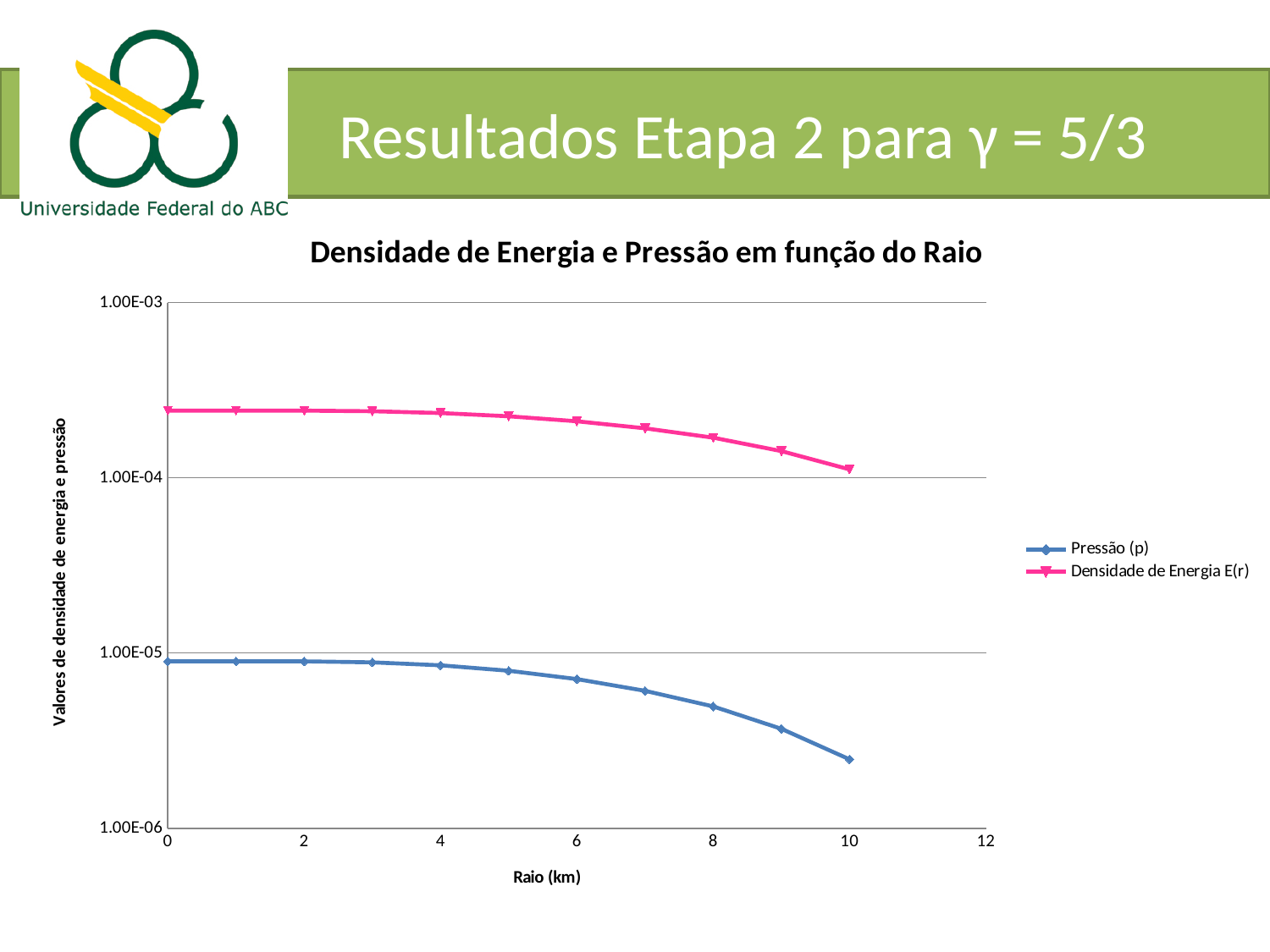
Is the value of Pressão (p) at a radius of 10 km greater or less than 1.00E-06? greater Is the value of Pressão (p) at a radius of 10 km greater or less than 1.00E-05? less At a radius of 6 km, which series has the larger value, Pressão (p) or Densidade de Energia E(r)? Densidade de Energia E(r) What kind of chart is shown on the slide? line chart What is the title of the chart? Densidade de Energia e Pressão em função do Raio What are the two series named in the legend? Pressão (p) and Densidade de Energia E(r) How many series does the legend list? 2 Do the values of the Densidade de Energia E(r) series rise or fall as the radius increases? fall Is the value of Densidade de Energia E(r) at a radius of 0 km greater or less than 1.00E-04? greater At which radius does the Pressão (p) series reach its lowest value? 10 How many data points are plotted for the Pressão (p) series? 11 Do the values of the Pressão (p) series rise or fall as the radius increases? fall